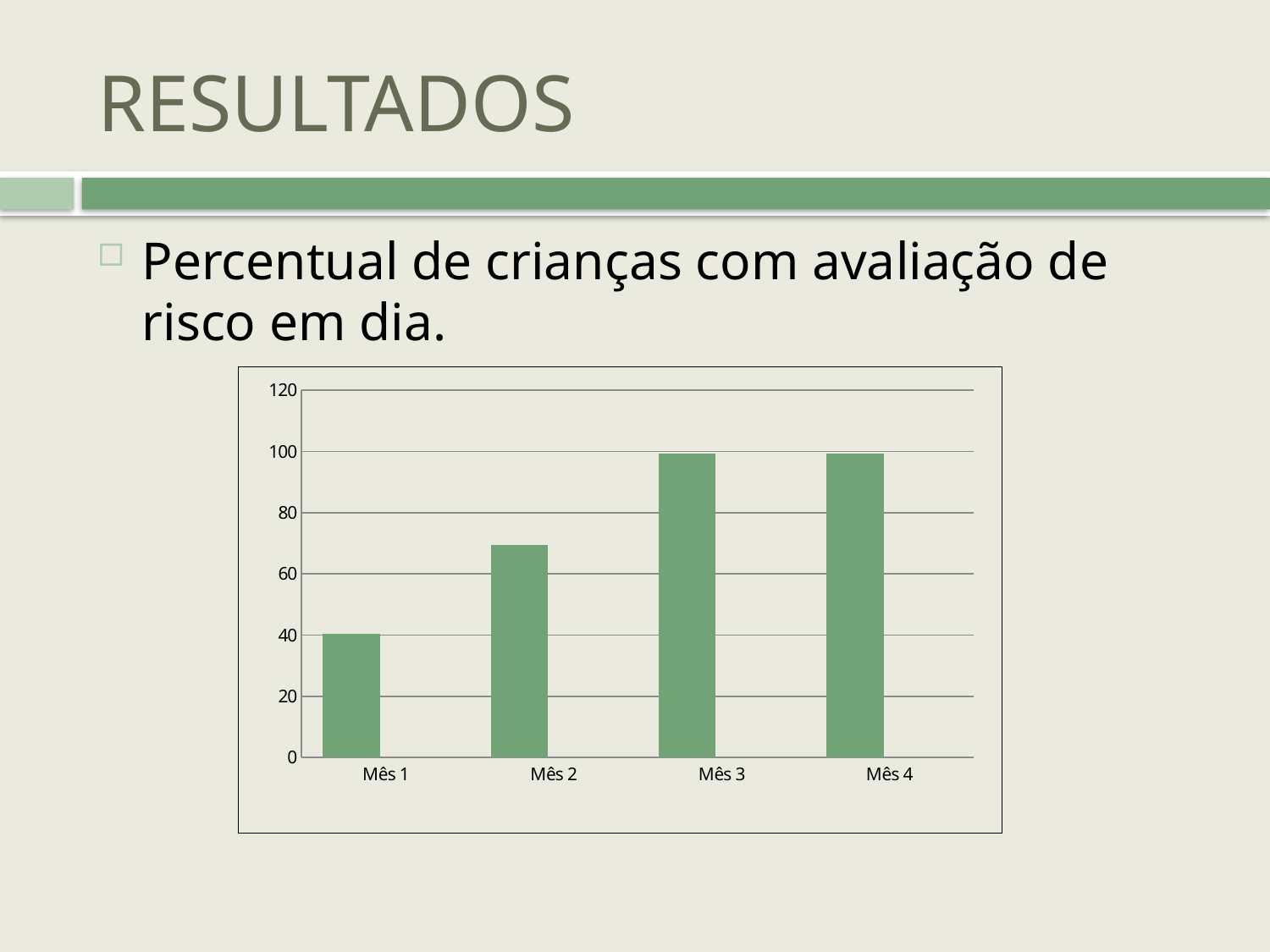
Do the values generally rise or fall from Mês 1 to Mês 4? rise What is the highest tick value shown on the vertical axis of the chart? 120 Is the value for Mês 2 greater or less than 80? less Is the value for Mês 3 greater or less than 80? greater Is the value for Mês 2 greater or less than 60? greater Which is larger, the value for Mês 1 or the value for Mês 2? Mês 2 Which month has the lowest value in the chart? Mês 1 Which is larger, the value for Mês 2 or the value for Mês 3? Mês 3 What kind of chart is shown on the slide? bar chart How many categories (months) are shown on the x axis of the chart? 4